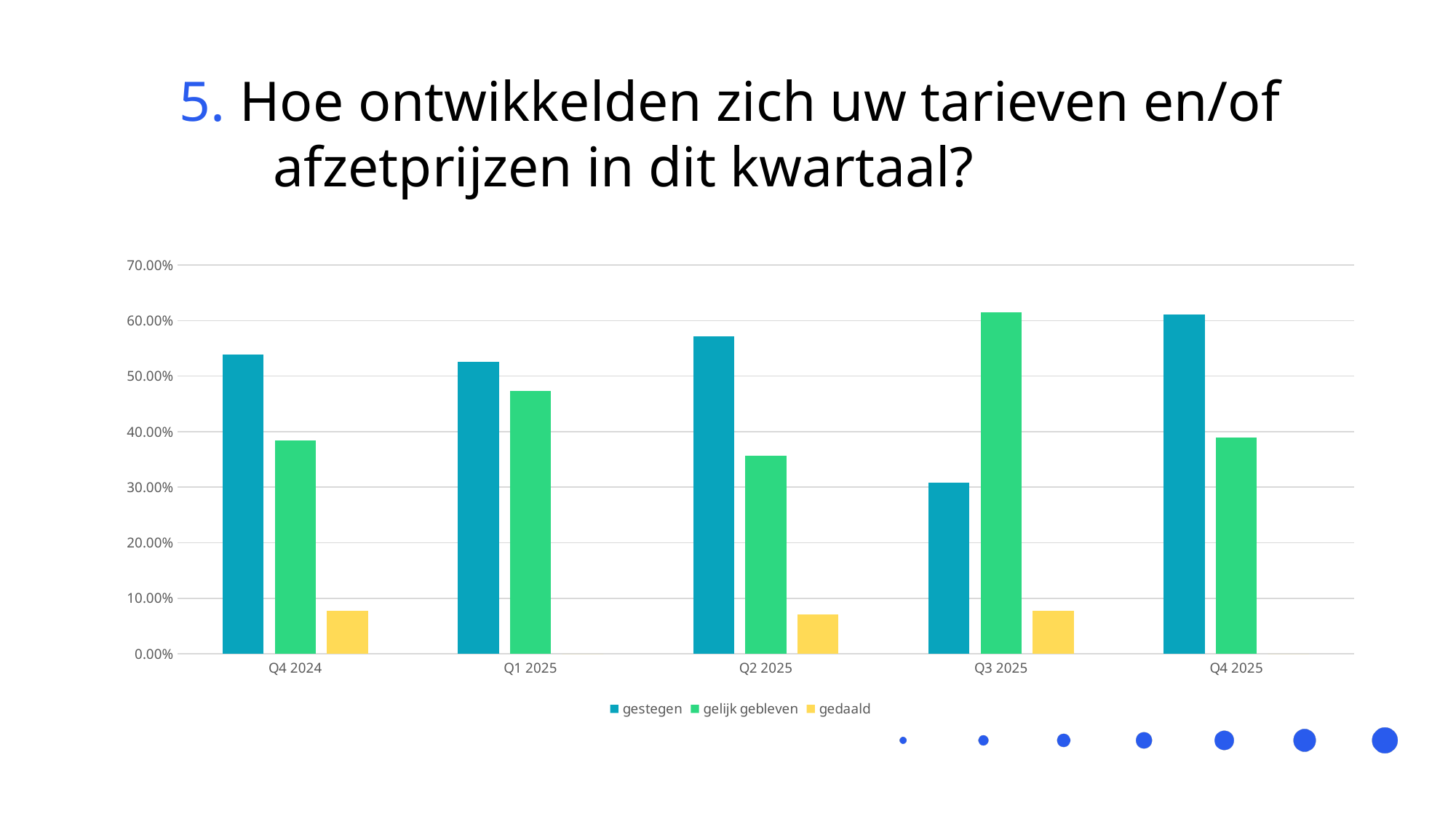
In Q4 2024, which is larger: 'gestegen' or 'gelijk gebleven'? gestegen In which quarter is the value for 'gestegen' the highest? Q4 2025 How many quarters are shown on the x axis of the chart? 5 Is the value for 'gedaald' in Q4 2024 greater or less than 10.00%? less Which series are listed in the legend of the chart? gestegen, gelijk gebleven, gedaald What kind of chart is shown on the slide? bar chart How many series does the legend of the chart list? 3 In which quarter is the value for 'gelijk gebleven' the highest? Q3 2025 Is the value for 'gestegen' in Q2 2025 greater or less than 50.00%? greater Is the value for 'gestegen' in Q3 2025 greater or less than 40.00%? less In which quarter is the value for 'gestegen' the lowest? Q3 2025 In Q3 2025, which is larger: 'gestegen' or 'gelijk gebleven'? gelijk gebleven